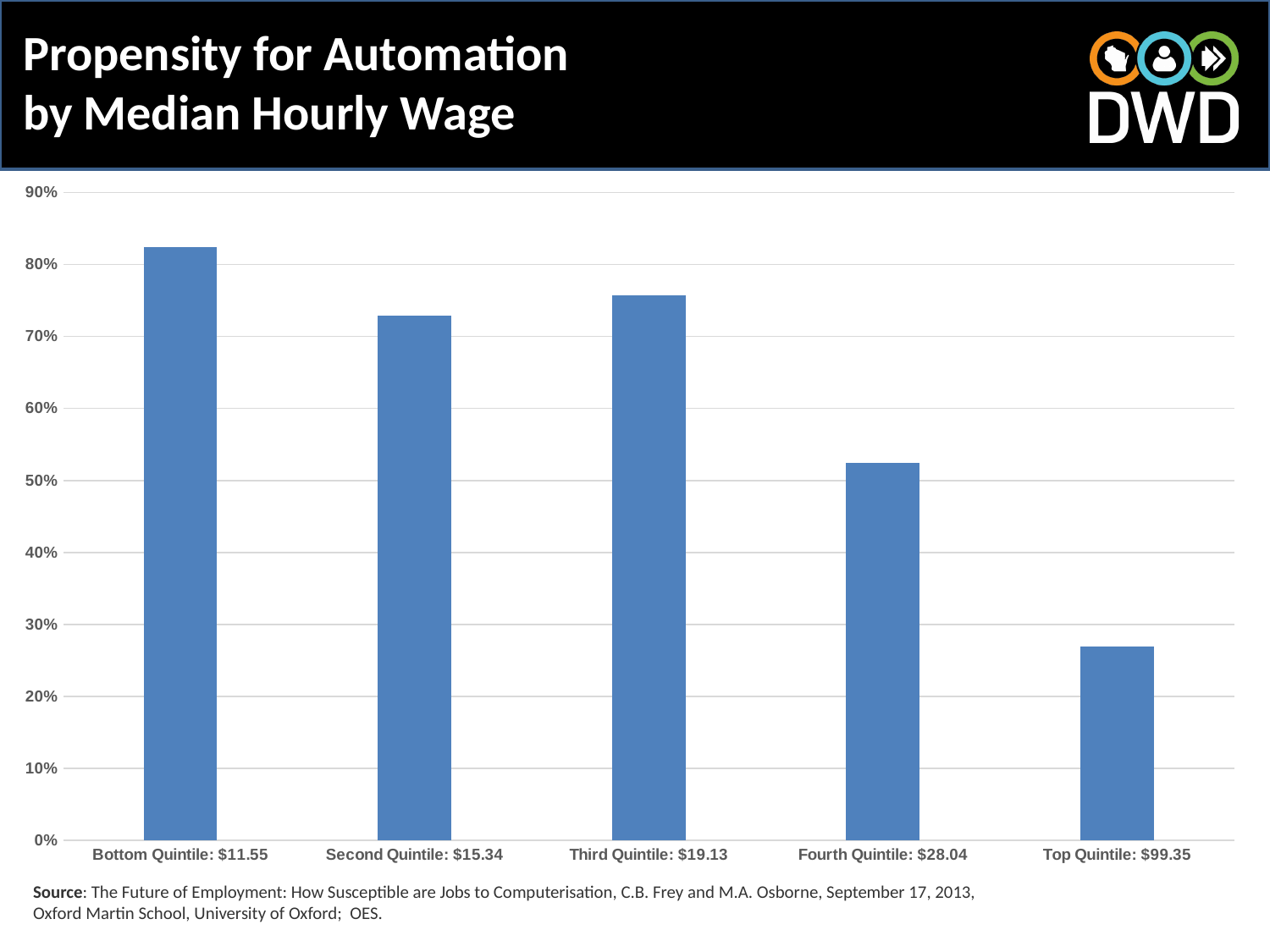
Which quintile has the lowest propensity for automation? Top Quintile: $99.35 Is the value for Third Quintile: $19.13 greater or less than 80%? less Is the value for Fourth Quintile: $28.04 greater or less than 50%? greater What is the title of the chart on the slide? Propensity for Automation by Median Hourly Wage Which quintile has the highest propensity for automation? Bottom Quintile: $11.55 Do the values generally rise or fall moving from the bottom quintile to the top quintile along the x axis? fall Is the value for Top Quintile: $99.35 greater or less than 30%? less What kind of chart is shown on the slide? bar chart How many wage quintile categories are plotted on the chart? 5 Which is larger, the value for Fourth Quintile: $28.04 or the value for Top Quintile: $99.35? Fourth Quintile: $28.04